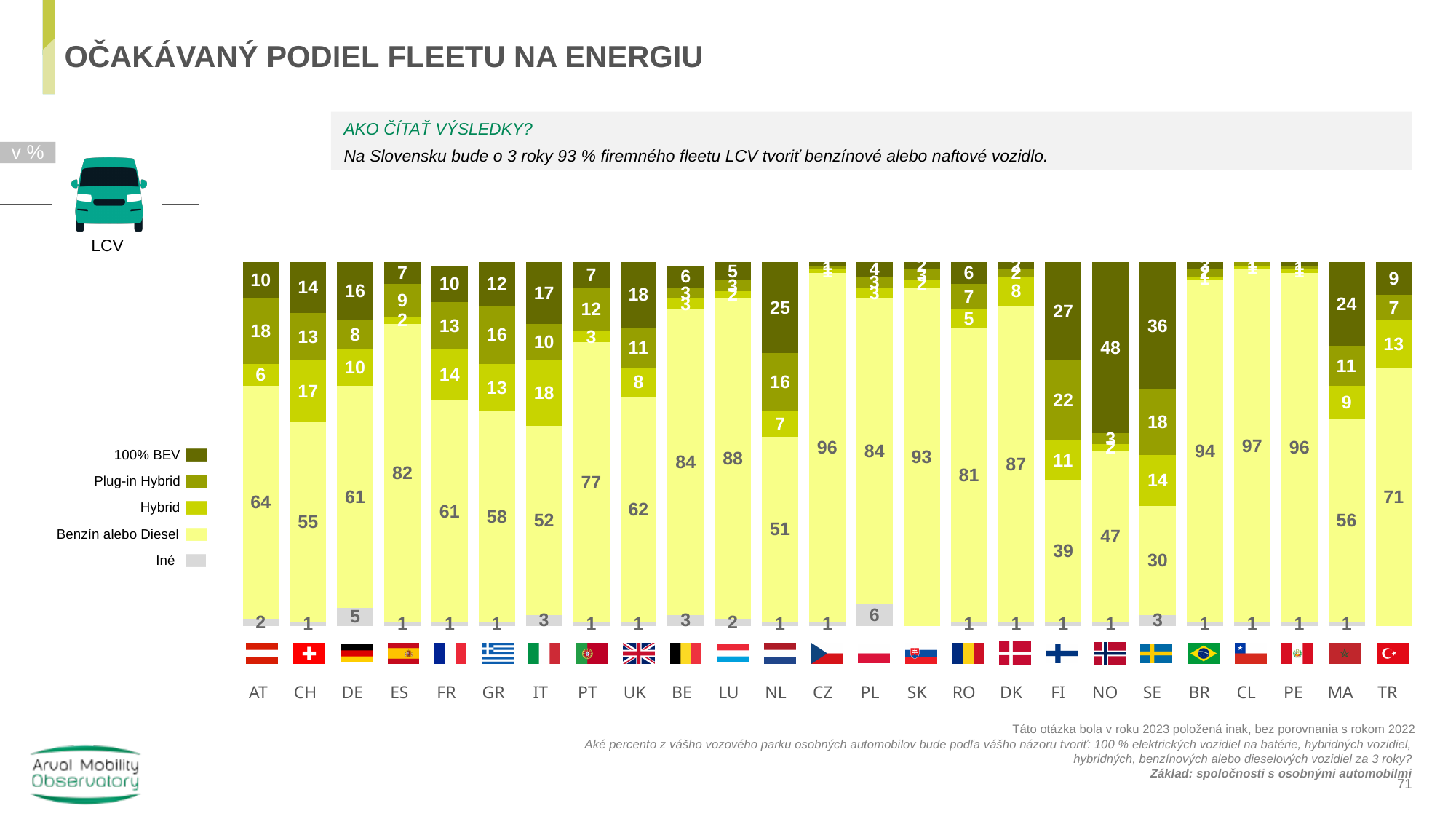
Which country has the highest Benzín alebo Diesel value? CL What is the total of the stacked bar for AT? 100 What is the Iné value for PL? 6 What is the difference between the Benzín alebo Diesel values for NL and FI? 12 Which country has the highest 100% BEV value? NO What is the Benzín alebo Diesel value for SK? 93 Which has the larger Hybrid value, FR or UK? FR Which country has the lowest Benzín alebo Diesel value? SE What kind of chart is shown on the slide? Stacked bar chart How many countries are shown on the x axis? 25 What is the 100% BEV value for NO? 48 How many series does the legend list? 5